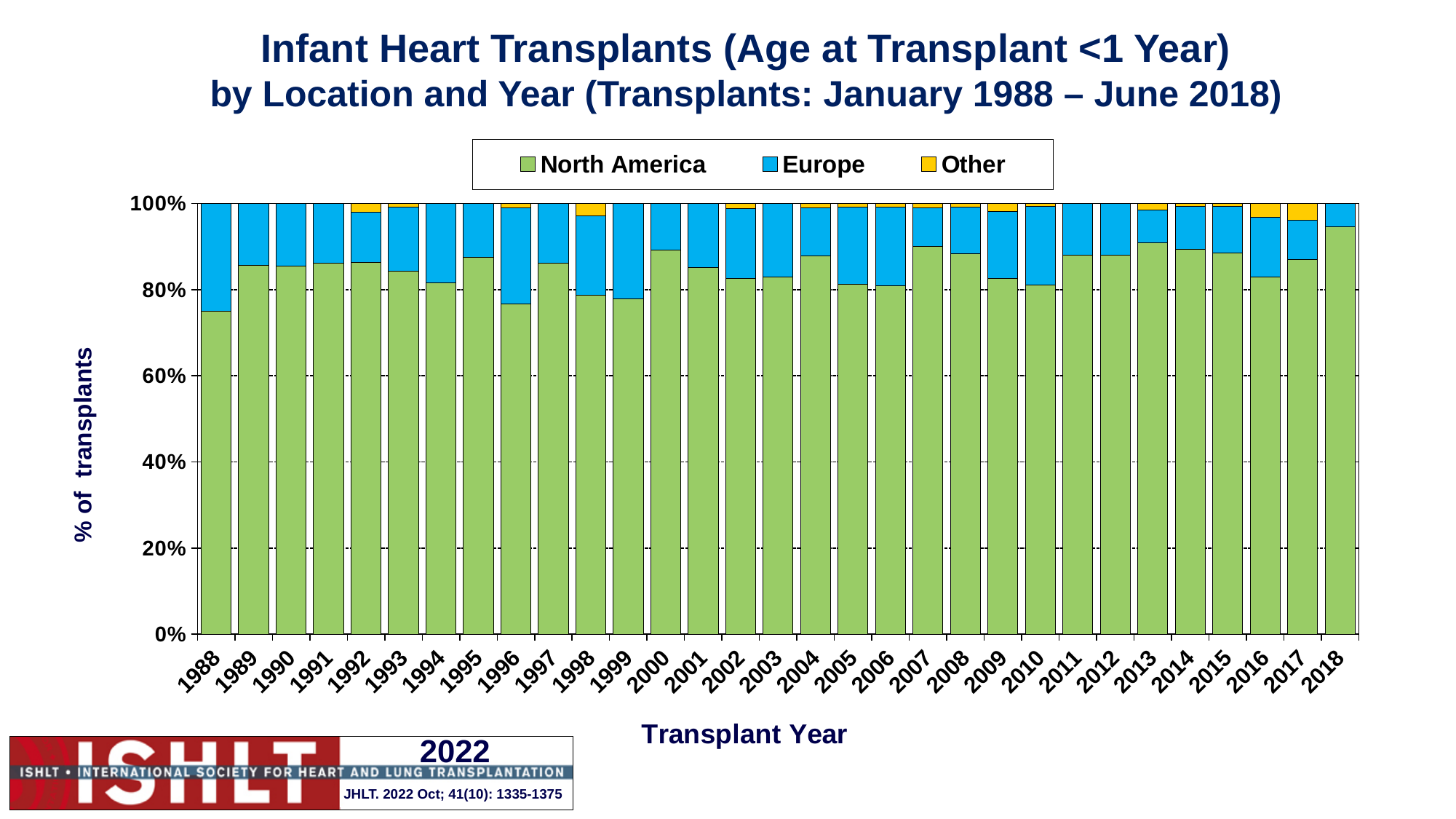
In which year is the North America share lowest? 1988 What is the label of the y axis? % of transplants Is the Europe share for 1988 greater or less than 20%? greater How many series does the legend list? 3 Is the North America share for 1988 greater or less than 80%? less Is the North America share for 2018 greater or less than 80%? greater Which series is shown in green? North America In which year is the North America share highest? 2018 Which year has the larger North America share, 1988 or 2018? 2018 What is the total height of the stacked bar for 2000? 100% How many transplant years are shown on the x axis? 31 What kind of chart is shown on the slide? stacked bar chart